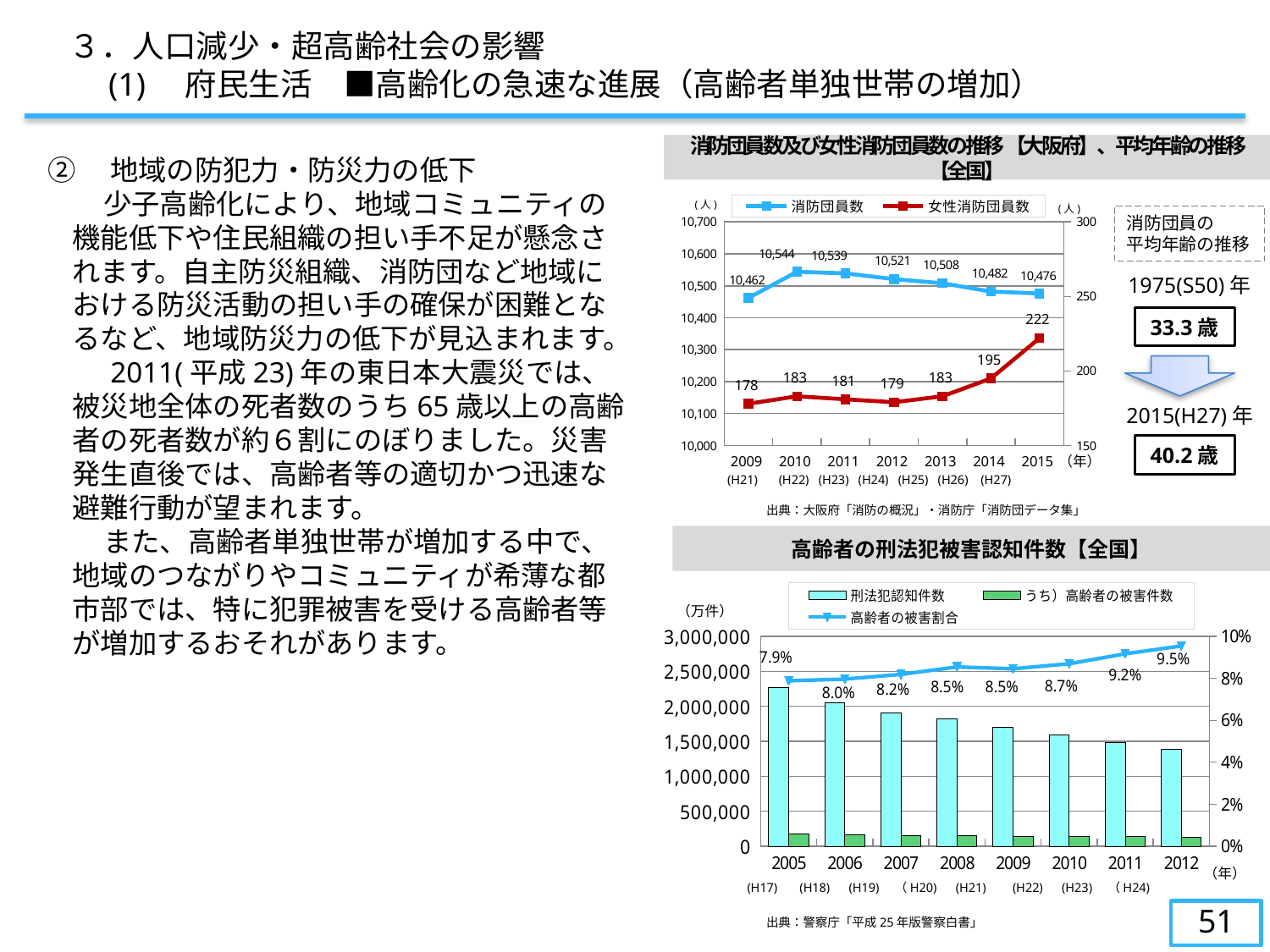
In the top chart (消防団員数及び女性消防団員数の推移), what is the value of 女性消防団員数 in 2015? 222 In the top chart (消防団員数及び女性消防団員数の推移), how many series does the legend list? 2 In the top chart (消防団員数及び女性消防団員数の推移), how many years are plotted on the x axis? 7 In the bottom chart (高齢者の刑法犯被害認知件数), what is the 高齢者の被害割合 in 2012? 9.5% In the top chart (消防団員数及び女性消防団員数の推移), in which year is 女性消防団員数 highest? 2015 In the top chart (消防団員数及び女性消防団員数の推移), does 消防団員数 rise or fall from 2010 to 2015? fall In the bottom chart (高齢者の刑法犯被害認知件数), is the 刑法犯認知件数 bar for 2005 greater or less than 2,000,000? greater In the bottom chart (高齢者の刑法犯被害認知件数), does 刑法犯認知件数 rise or fall from 2005 to 2012? fall In the top chart (消防団員数及び女性消防団員数の推移), in which year is 消防団員数 lowest? 2009 In the top chart (消防団員数及び女性消防団員数の推移), what is the value of 消防団員数 in 2010? 10,544 In the bottom chart (高齢者の刑法犯被害認知件数), in which year is 高齢者の被害割合 lowest? 2005 In the top chart (消防団員数及び女性消防団員数の推移), what is the difference in 女性消防団員数 between 2015 and 2014? 27